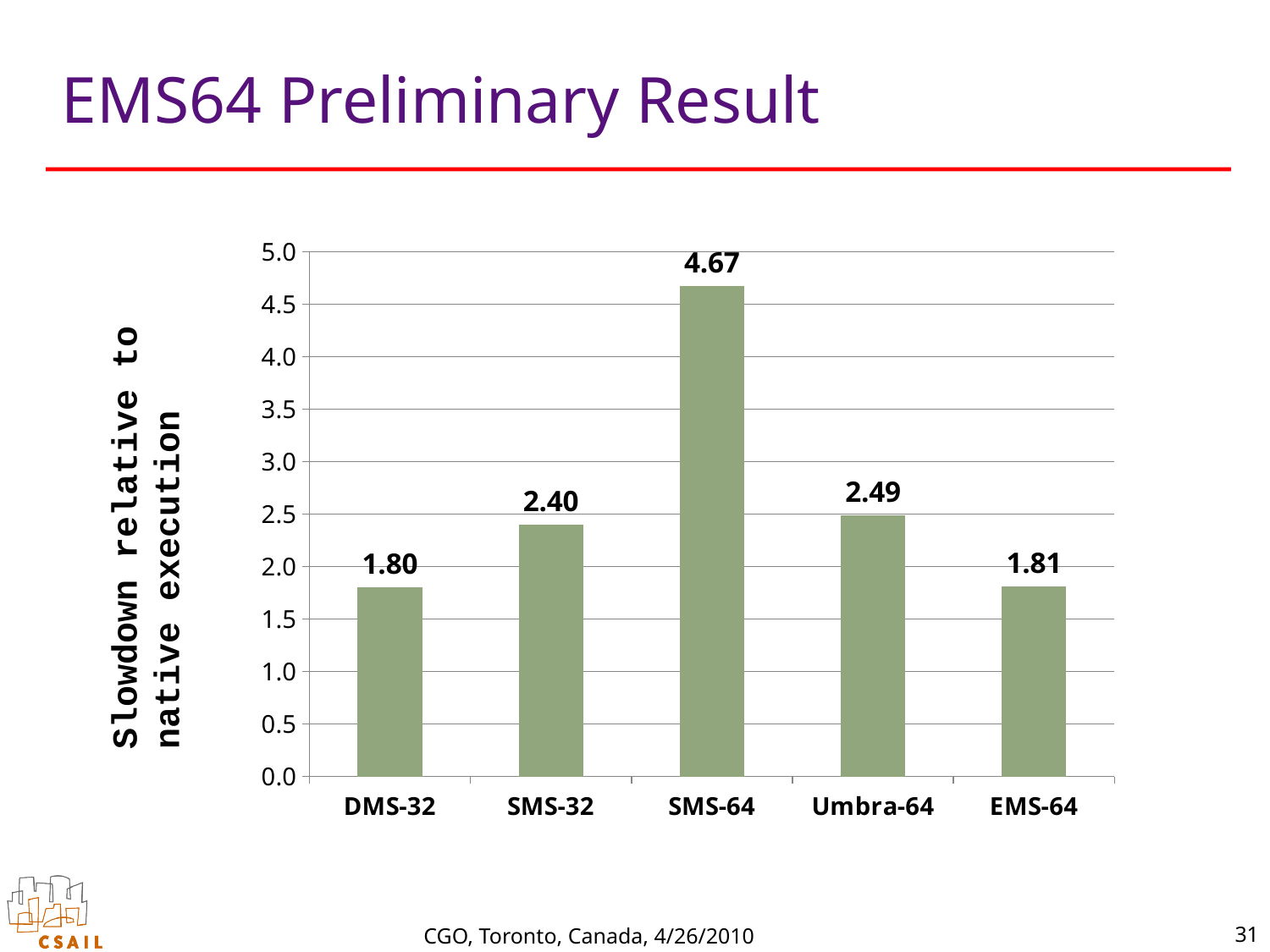
What is the difference between the slowdown for SMS-32 and DMS-32? 0.60 What is the slowdown value for Umbra-64? 2.49 Is the value for SMS-64 greater or less than 4.5? greater What is the difference between the slowdown for SMS-64 and Umbra-64? 2.18 Which category has the highest slowdown? SMS-64 Which category has the lowest slowdown? DMS-32 Which has a larger slowdown, SMS-32 or Umbra-64? Umbra-64 What is the slowdown value for EMS-64? 1.81 What is the label of the y axis? Slowdown relative to native execution How many categories are shown on the x axis? 5 What is the slowdown value for SMS-64? 4.67 What kind of chart is shown on the slide? bar chart